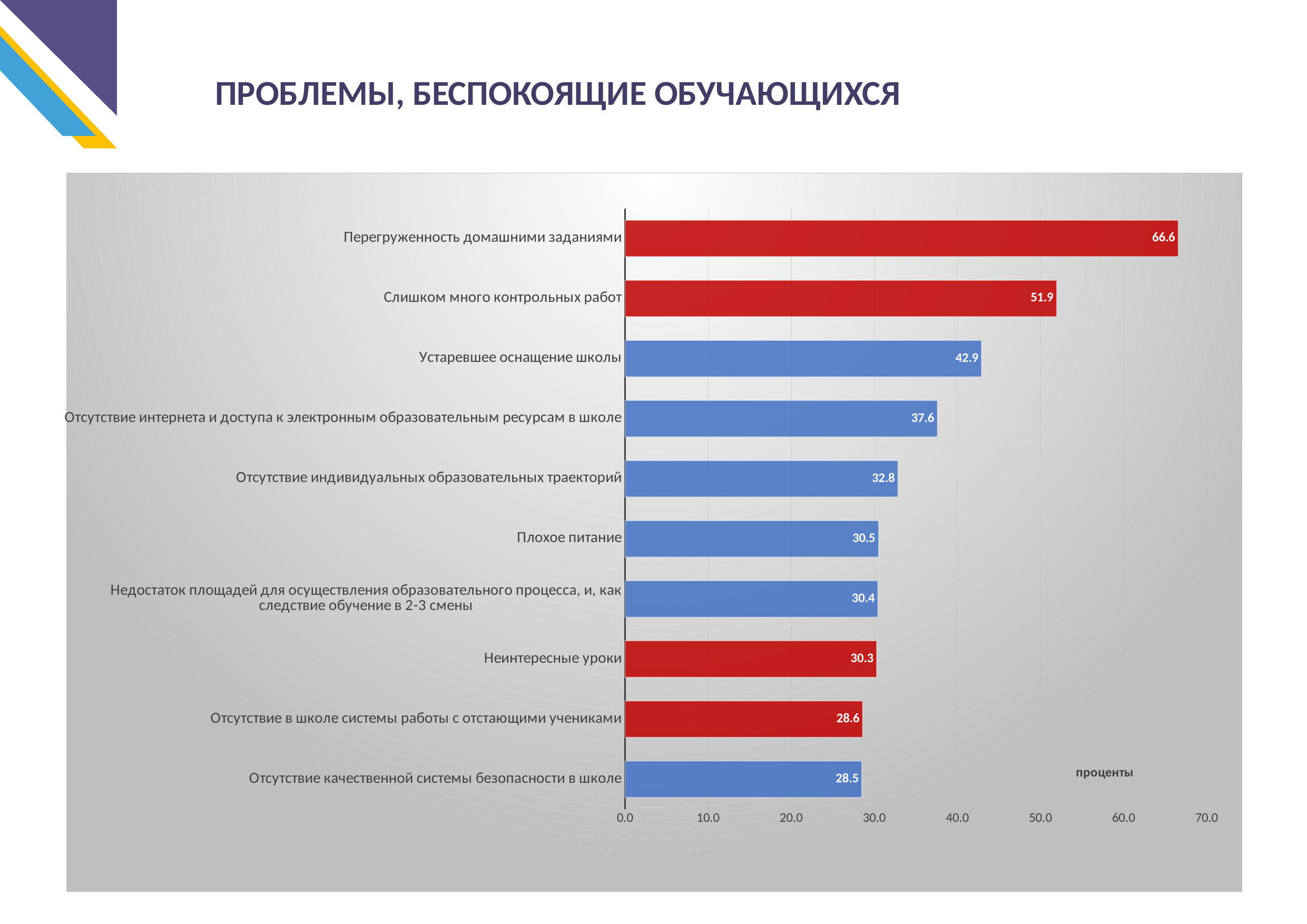
What is the value for «Устаревшее оснащение школы»? 42.9 Which category has the lowest value? Отсутствие качественной системы безопасности в школе What is the value for «Отсутствие в школе системы работы с отстающими учениками»? 28.6 What is the value for «Плохое питание»? 30.5 What kind of chart is shown on the slide? bar chart Is the value for «Слишком много контрольных работ» greater or less than 50.0? greater What is the difference between the values for «Перегруженность домашними заданиями» and «Слишком много контрольных работ»? 14.7 What is the title of the slide? ПРОБЛЕМЫ, БЕСПОКОЯЩИЕ ОБУЧАЮЩИХСЯ What is the value for «Перегруженность домашними заданиями»? 66.6 Which is larger: the value for «Отсутствие интернета и доступа к электронным образовательным ресурсам в школе» or for «Отсутствие индивидуальных образовательных траекторий»? Отсутствие интернета и доступа к электронным образовательным ресурсам в школе How many categories are shown in the chart? 10 Which category has the highest value? Перегруженность домашними заданиями